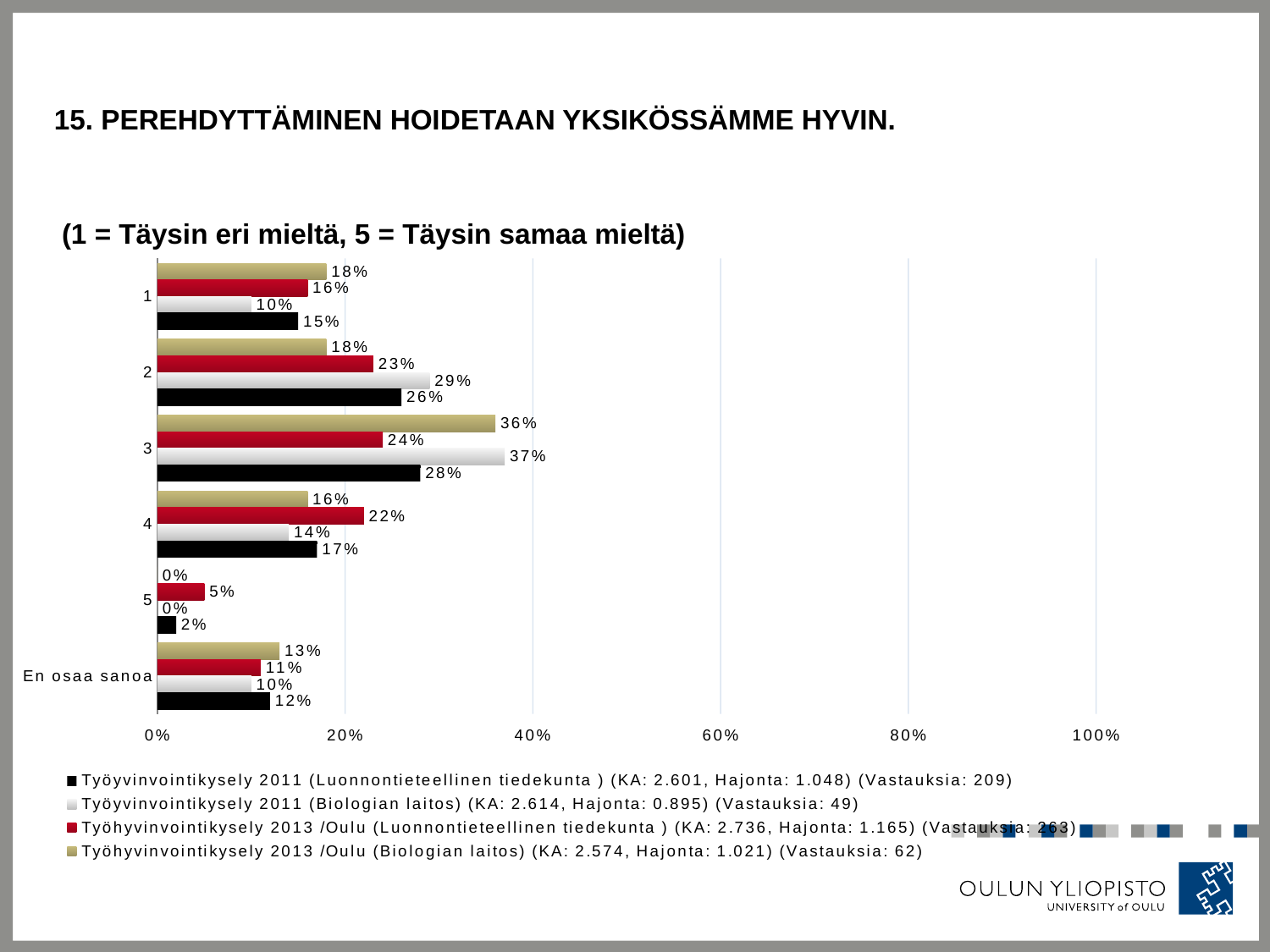
What type of chart is shown on the slide? bar chart Which category has the lowest value in the Työhyvinvointikysely 2013 /Oulu (Luonnontieteellinen tiedekunta) series? 5 Is the value for category 3 in the Työyvinvointikysely 2011 (Biologian laitos) series greater or less than 20%? greater What is the difference between the Työhyvinvointikysely 2013 /Oulu (Biologian laitos) value and the Työhyvinvointikysely 2013 /Oulu (Luonnontieteellinen tiedekunta) value for category 3? 12% What is the value for category 2 in the Työhyvinvointikysely 2013 /Oulu (Luonnontieteellinen tiedekunta) series? 23% For category 4, which series has the larger value: Työhyvinvointikysely 2013 /Oulu (Luonnontieteellinen tiedekunta) or Työyvinvointikysely 2011 (Biologian laitos)? Työhyvinvointikysely 2013 /Oulu (Luonnontieteellinen tiedekunta) What is the value for category 3 in the Työyvinvointikysely 2011 (Biologian laitos) series? 37% Which category has the highest value in the Työyvinvointikysely 2011 (Luonnontieteellinen tiedekunta) series? 3 What is the value for 'En osaa sanoa' in the Työhyvinvointikysely 2013 /Oulu (Biologian laitos) series? 13% How many series does the legend list? 4 What is the number of responses (Vastauksia) given in the legend for Työhyvinvointikysely 2013 /Oulu (Biologian laitos)? 62 How many categories are shown on the vertical axis of the chart? 6